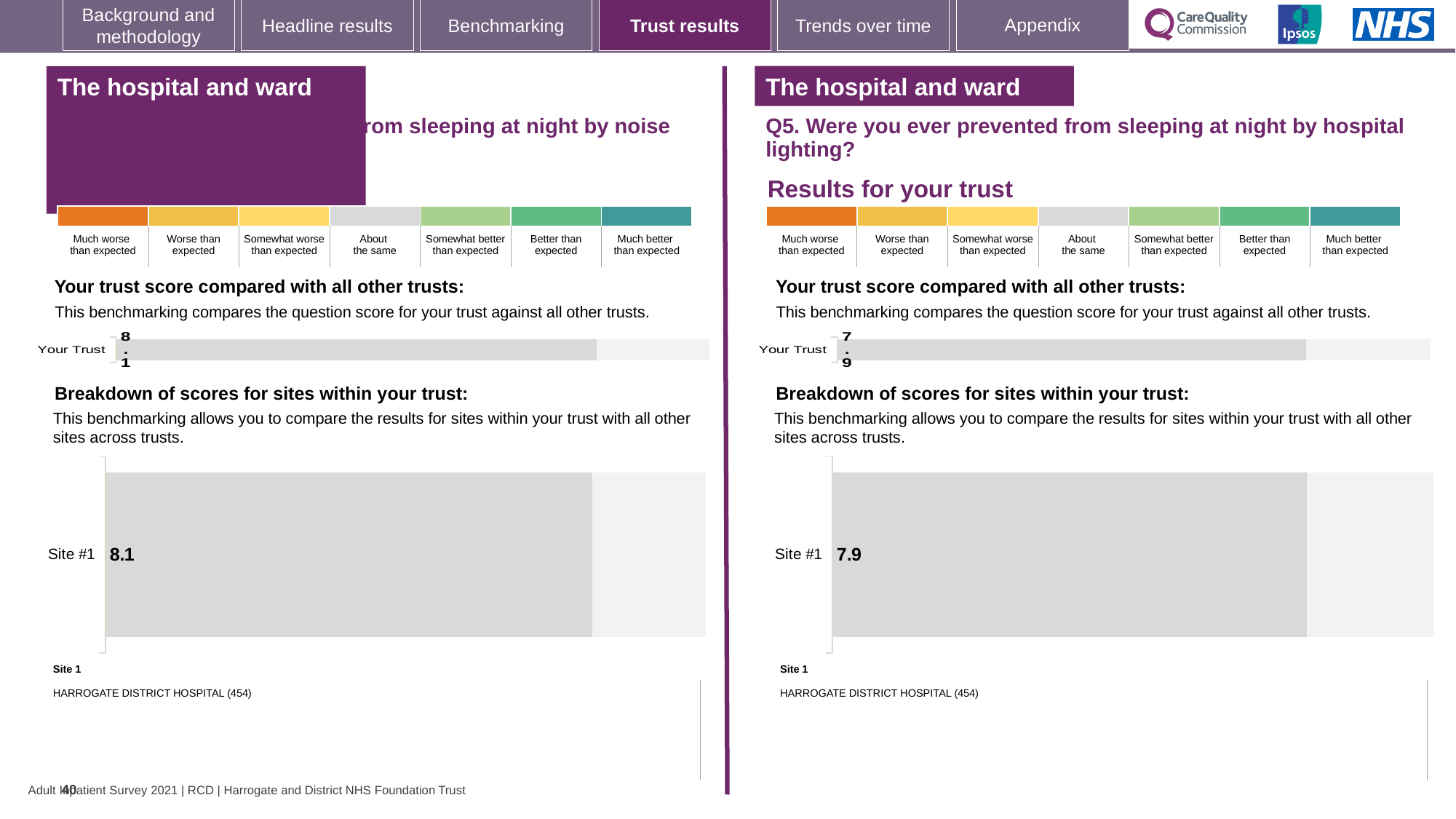
What type of chart is used to show the Your Trust score on the right-hand side (Q5, hospital lighting)? Bar chart In the right-hand breakdown of scores for sites chart (Q5, hospital lighting), what is the score for Site #1? 7.9 How many categories are shown in the colour scale above the right-hand chart, from 'Much worse than expected' to 'Much better than expected'? 7 Which trust score is higher: the left-hand chart (noise) or the right-hand chart (Q5, hospital lighting)? The left-hand chart (noise), 8.1 Which hospital is listed as Site 1 beneath the breakdown charts? HARROGATE DISTRICT HOSPITAL (454) On the left-hand chart (prevented from sleeping at night by noise), what is the score shown for Your Trust? 8.1 How many bars are plotted in the left-hand Your Trust chart (sleeping at night by noise)? 1 How many sites are shown in the right-hand breakdown of scores for sites chart (Q5, hospital lighting)? 1 In the left-hand breakdown of scores for sites chart (sleeping at night by noise), what is the score for Site #1? 8.1 On the right-hand chart (Q5, hospital lighting), is the Site #1 score higher than, lower than, or the same as the Your Trust score? The same On the right-hand chart for Q5 (prevented from sleeping at night by hospital lighting), what is the score shown for Your Trust? 7.9 What is the difference between the Your Trust score on the left-hand chart (8.1) and the Your Trust score on the right-hand chart (7.9)? 0.2